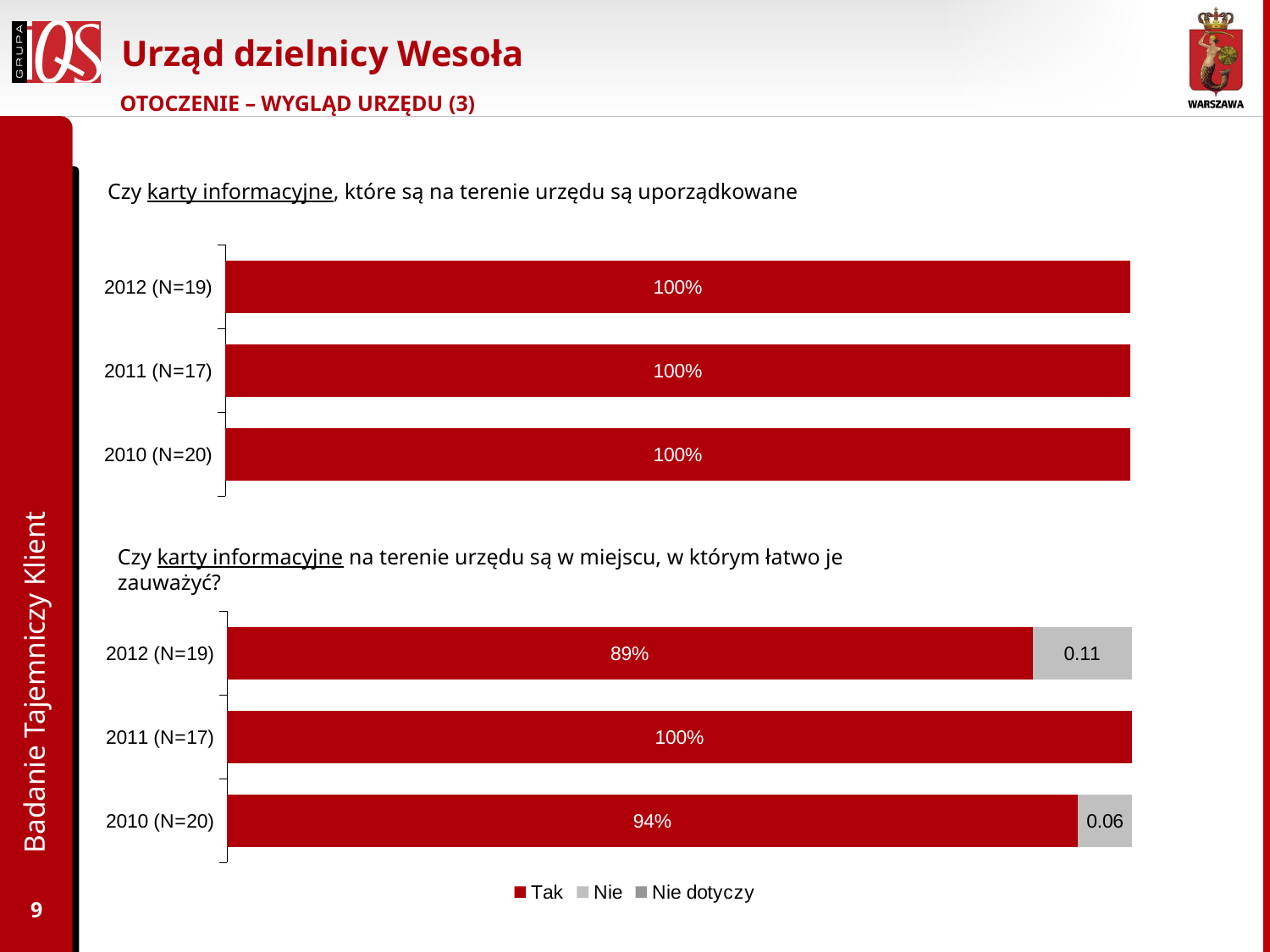
In the bottom chart, what is the 'Tak' value for 2010 (N=20)? 94% What kind of chart is the bottom chart? bar chart In the bottom chart, which year has the highest 'Tak' value? 2011 (N=17) In the bottom chart, what is the 'Nie' value labelled for 2010 (N=20)? 0.06 How many series does the legend at the bottom of the slide list? 3 In the top chart, how many categories are shown on the vertical axis? 3 In the top chart, what is the value for 2012 (N=19)? 100% In the bottom chart, what is the 'Tak' value for 2012 (N=19)? 89% In the bottom chart, which year has the lowest 'Tak' value? 2012 (N=19) In the bottom chart, what is the 'Nie' value labelled for 2012 (N=19)? 0.11 In the bottom chart, what is the difference between the 'Tak' values for 2010 (N=20) and 2012 (N=19)? 5% In the bottom chart, what is the 'Tak' value for 2011 (N=17)? 100%